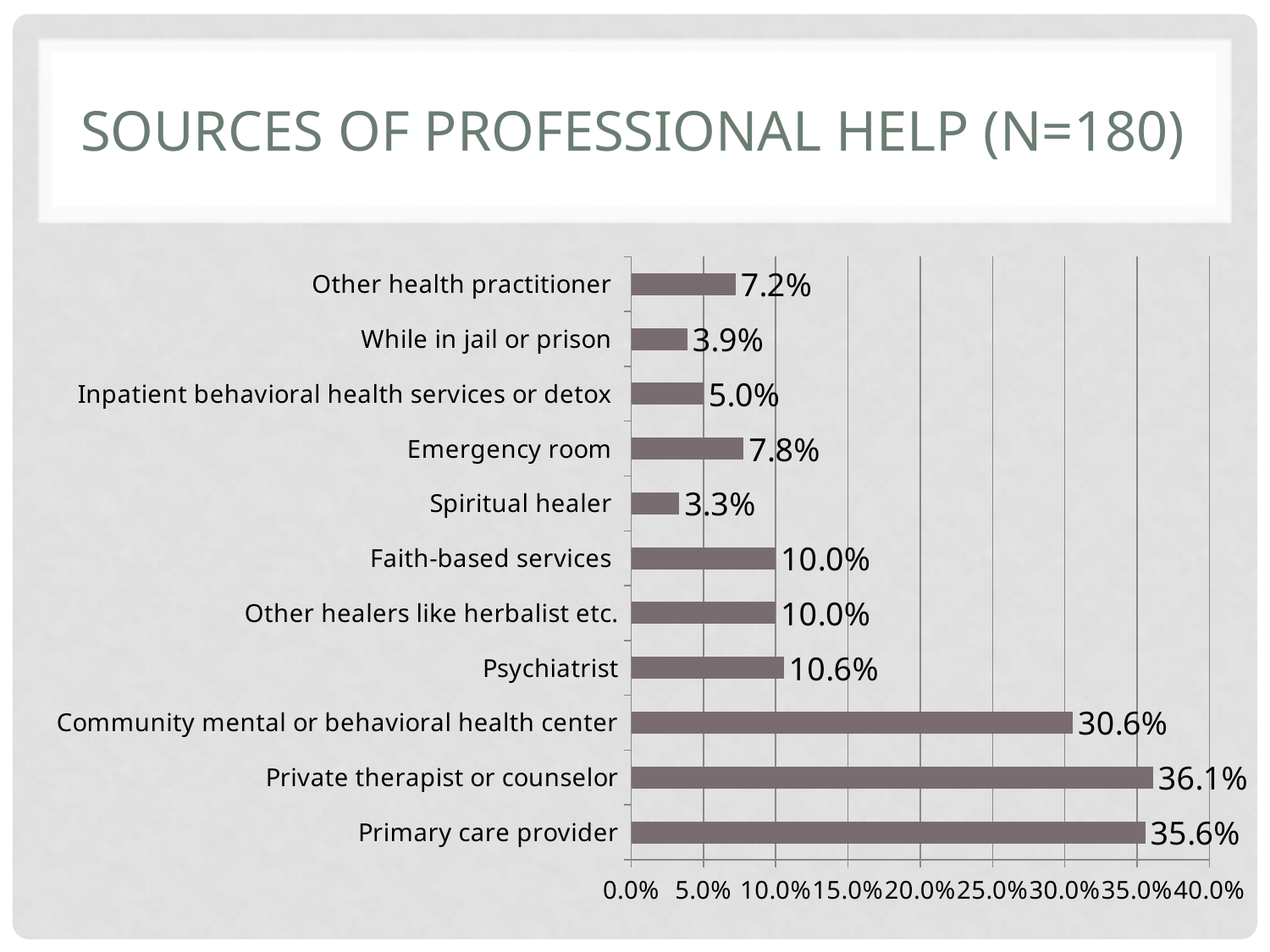
What is the value for Spiritual healer? 3.3% What percentage is shown for Community mental or behavioral health center? 30.6% Which source of professional help has the lowest percentage? Spiritual healer How many categories are shown in the chart? 11 What is the title of the chart on the slide? Sources of Professional Help (N=180) What kind of chart is shown on the slide? Bar chart Which is larger, the value for Emergency room or the value for Other health practitioner? Emergency room What is the difference between the values for Faith-based services and While in jail or prison? 6.1% Which source of professional help has the highest percentage? Private therapist or counselor Is the value for Psychiatrist greater or less than 10.0%? greater What is the difference between the values for Primary care provider and Community mental or behavioral health center? 5.0% What percentage is shown for Private therapist or counselor? 36.1%